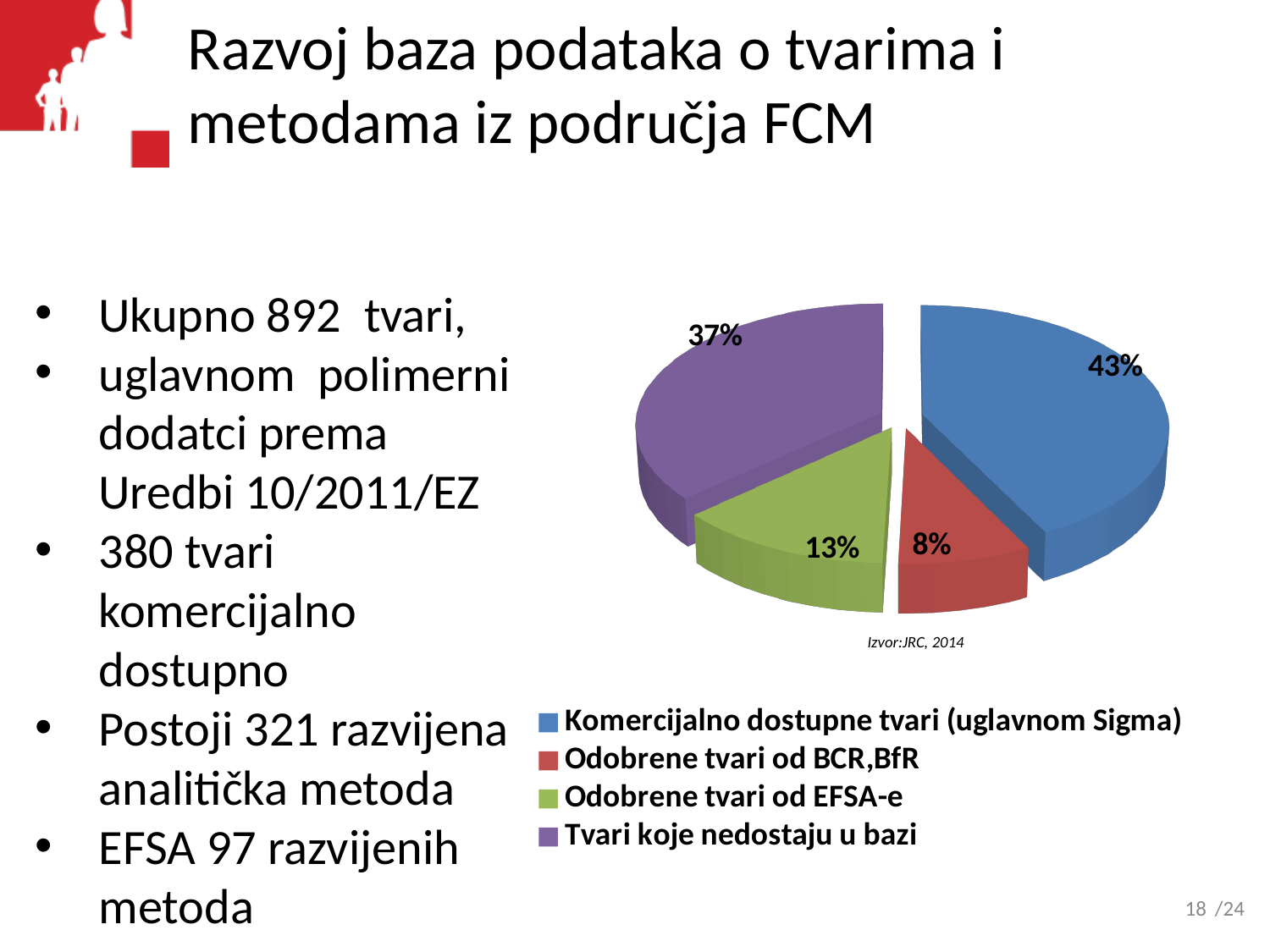
What share of the pie is labelled for Odobrene tvari od EFSA-e? 13% What colour is the slice for Tvari koje nedostaju u bazi? purple What is the difference in percentage points between Komercijalno dostupne tvari (uglavnom Sigma) and Tvari koje nedostaju u bazi? 6% How many entries does the legend list? 4 Which category has the smallest slice of the pie? Odobrene tvari od BCR,BfR Which category has the largest slice of the pie? Komercijalno dostupne tvari (uglavnom Sigma) How many slices does the pie chart have? 4 What share of the pie is labelled for Komercijalno dostupne tvari (uglavnom Sigma)? 43% What share of the pie is labelled for Tvari koje nedostaju u bazi? 37% Which is larger: the slice for Odobrene tvari od EFSA-e or the slice for Odobrene tvari od BCR,BfR? Odobrene tvari od EFSA-e What kind of chart is shown on the slide? pie chart